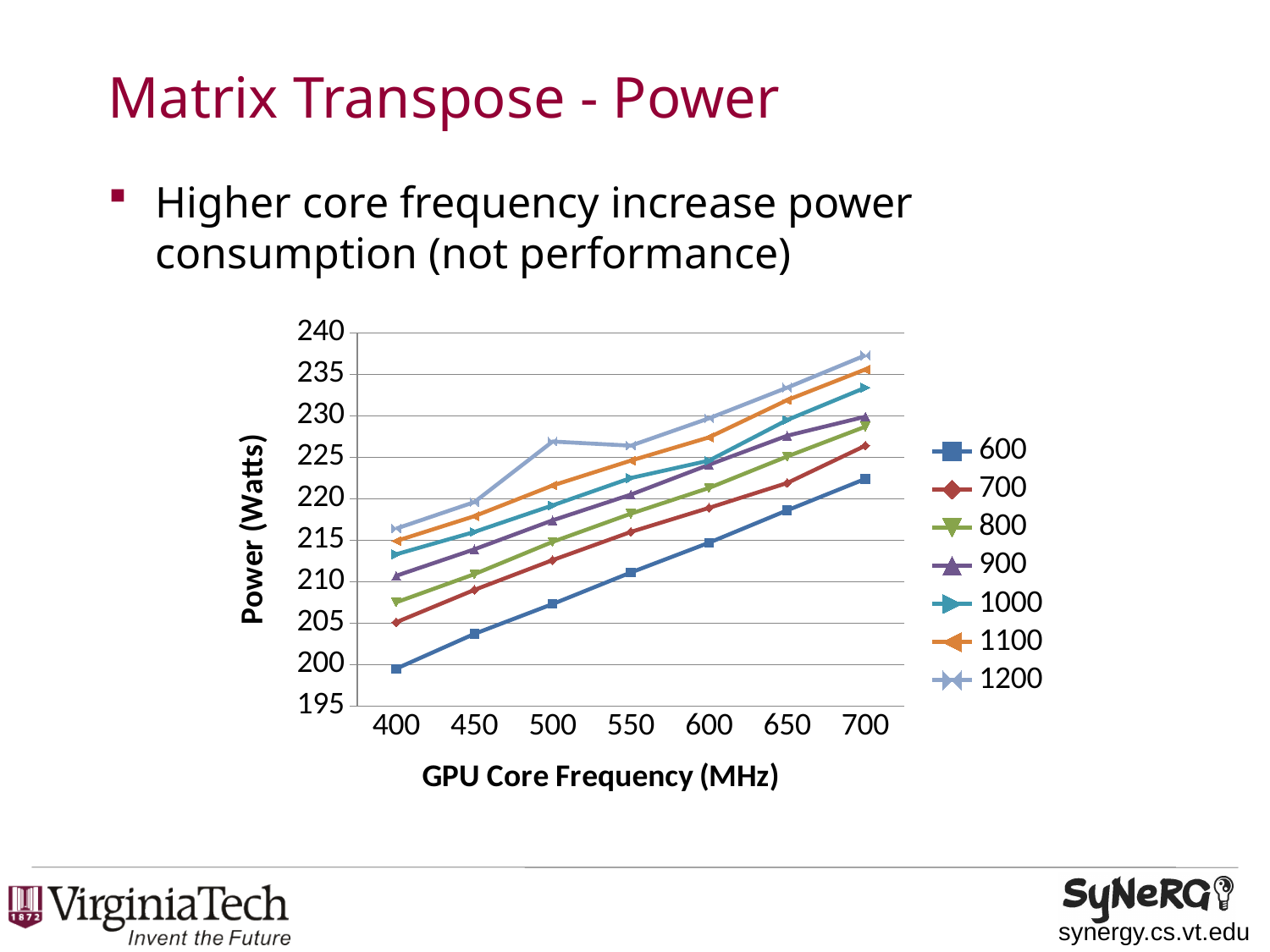
At 400 MHz, which series has higher power, 900 or 1000? 1000 Is the power for the 600 series at 700 MHz greater or less than 220? greater At 500 MHz, which series has higher power, 1100 or 1200? 1200 Is the power for the 1200 series at 700 MHz greater or less than 235? greater Is the power for the 600 series at 500 MHz greater or less than 210? less Do the power values for the 600 series rise or fall as GPU core frequency increases from 400 to 700 MHz? rise Which series has the lowest power at 400 MHz? 600 How many GPU core frequency points are plotted along the x axis? 7 Which series has the highest power at 700 MHz? 1200 What kind of chart is shown on the slide? line chart What is the title of the y axis? Power (Watts) How many series does the legend list? 7